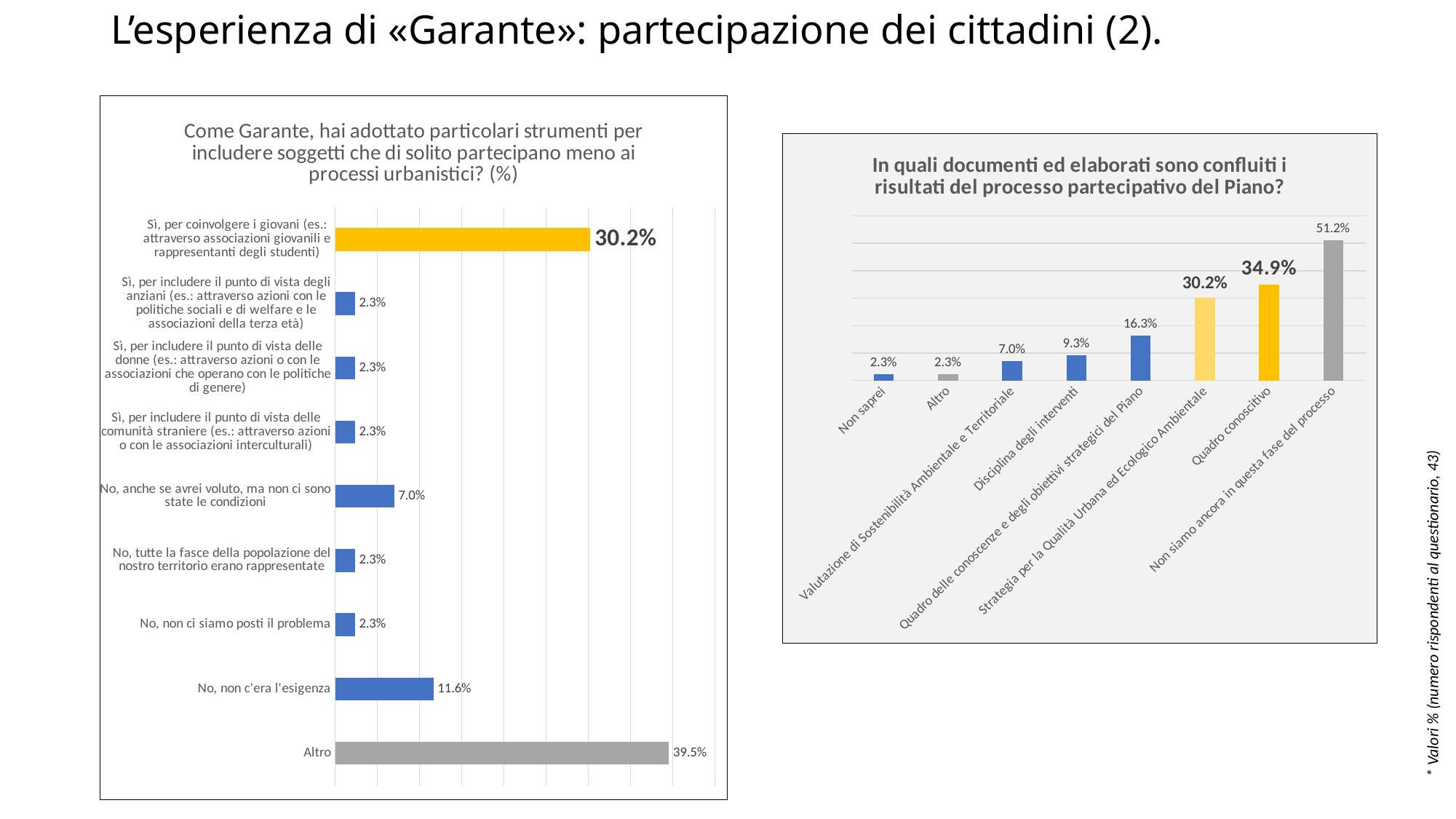
In the left chart ("Come Garante, hai adottato particolari strumenti..."), what is the difference between "Altro" and "Sì, per coinvolgere i giovani"? 9.3% In the right chart ("In quali documenti ed elaborati sono confluiti..."), what is the value for "Quadro conoscitivo"? 34.9% In the left chart ("Come Garante, hai adottato particolari strumenti..."), what is the value for "Altro"? 39.5% In the left chart ("Come Garante, hai adottato particolari strumenti..."), how many categories are shown? 9 In the right chart ("In quali documenti ed elaborati sono confluiti..."), what is the value for "Disciplina degli interventi"? 9.3% In the left chart ("Come Garante, hai adottato particolari strumenti..."), what is the value for "No, non c'era l'esigenza"? 11.6% What type of chart is the left chart ("Come Garante, hai adottato particolari strumenti...")? Bar chart In the right chart ("In quali documenti ed elaborati sono confluiti..."), what is the difference between "Non siamo ancora in questa fase del processo" and "Quadro delle conoscenze e degli obiettivi strategici del Piano"? 34.9% In the left chart ("Come Garante, hai adottato particolari strumenti..."), which category has the highest value? Altro In the right chart ("In quali documenti ed elaborati sono confluiti..."), how many categories are shown? 8 In the right chart ("In quali documenti ed elaborati sono confluiti..."), which category has the highest value? Non siamo ancora in questa fase del processo In the right chart ("In quali documenti ed elaborati sono confluiti..."), which is larger: "Quadro conoscitivo" or "Strategia per la Qualità Urbana ed Ecologico Ambientale"? Quadro conoscitivo